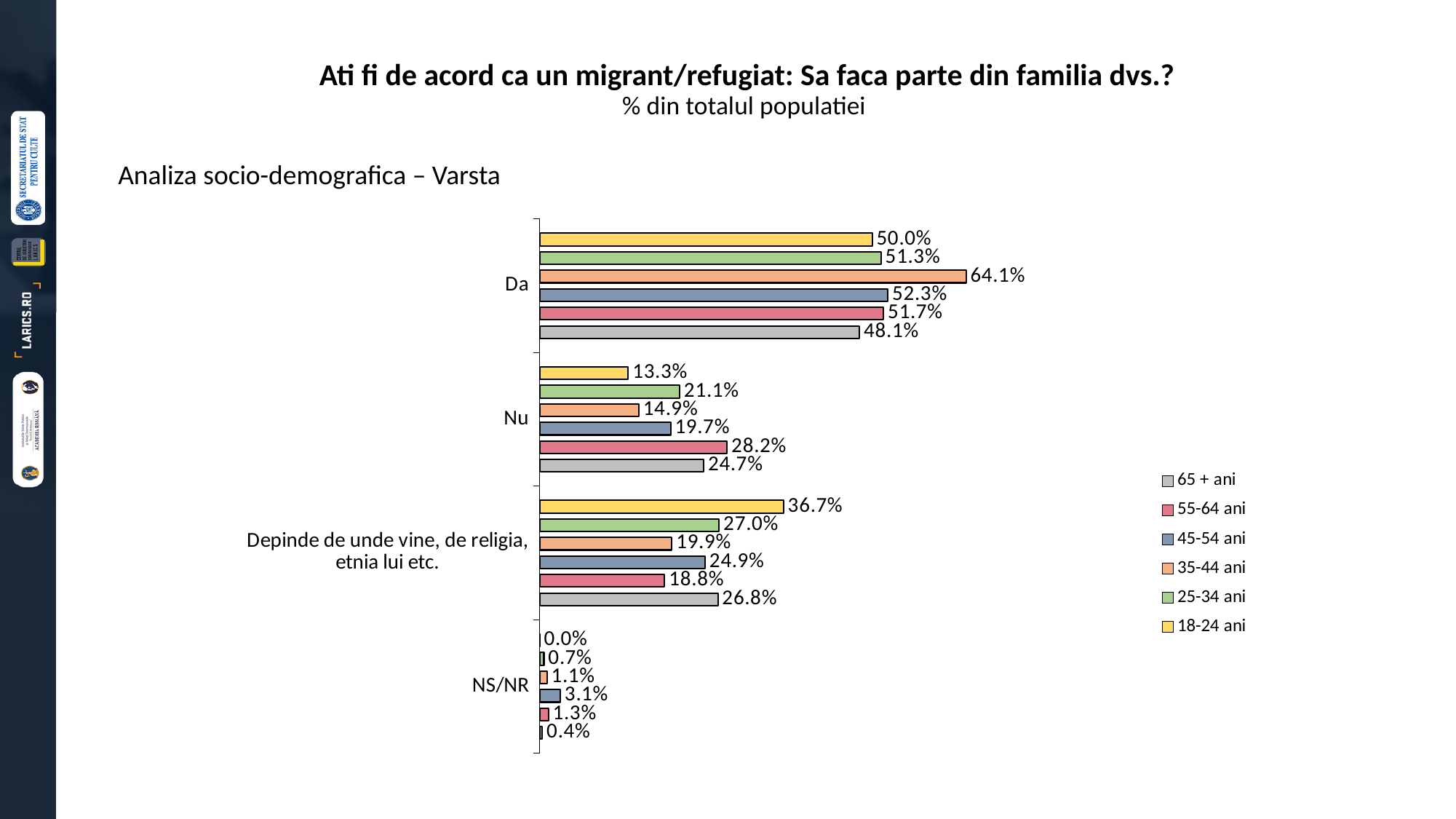
Which age group is shown in yellow in the legend? 18-24 ani How many response categories are shown on the chart? 4 How many age groups does the legend list? 6 Which age group has the highest value in the "Da" category? 35-44 ani Which age group has the lowest value in the "Nu" category? 18-24 ani What is the value for the 18-24 ani group in the "Depinde de unde vine, de religia, etnia lui etc." category? 36.7% What is the difference between the 35-44 ani and 65 + ani values in the "Da" category? 16.0% What type of chart is shown on the slide? Bar chart In the "Depinde de unde vine, de religia, etnia lui etc." category, which is larger: the value for 25-34 ani or for 45-54 ani? 25-34 ani What is the value for the 45-54 ani group in the "NS/NR" category? 3.1% What percentage of the 35-44 ani group answered "Da"? 64.1% What is the value for the 55-64 ani group in the "Nu" category? 28.2%